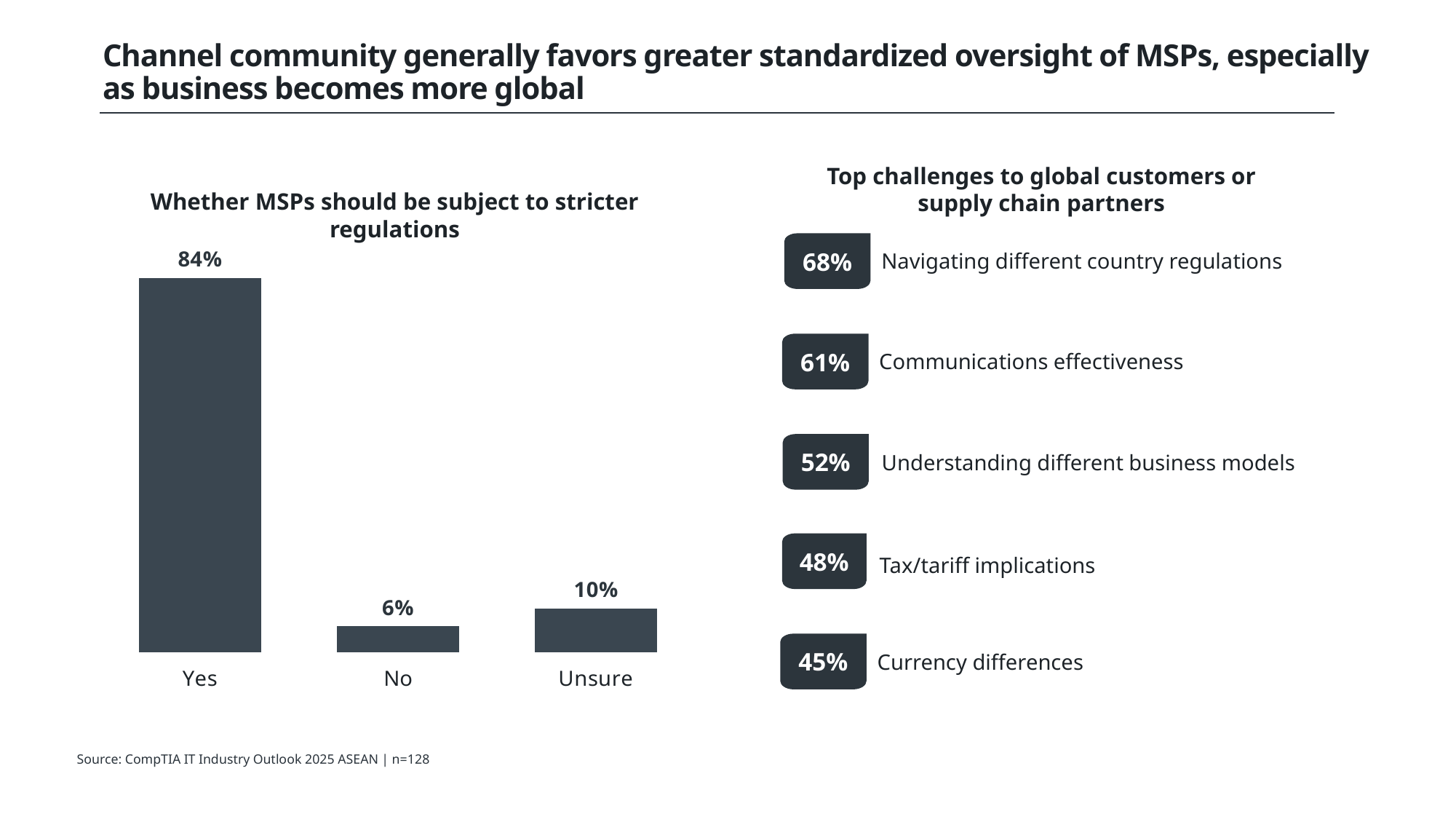
In the chart 'Whether MSPs should be subject to stricter regulations', what is the value for Unsure? 10% In the chart 'Whether MSPs should be subject to stricter regulations', what is the difference between the Yes and Unsure values? 74 percentage points In the chart 'Whether MSPs should be subject to stricter regulations', which is larger, No or Unsure? Unsure In the chart 'Whether MSPs should be subject to stricter regulations', what is the value for No? 6% In the 'Top challenges to global customers or supply chain partners' list, what is the value for Tax/tariff implications? 48% In the 'Top challenges to global customers or supply chain partners' list, which challenge has the highest value? Navigating different country regulations How many categories are shown in the chart 'Whether MSPs should be subject to stricter regulations'? 3 In the chart 'Whether MSPs should be subject to stricter regulations', which category has the lowest value? No In the chart 'Whether MSPs should be subject to stricter regulations', what is the value for Yes? 84% In the chart 'Whether MSPs should be subject to stricter regulations', which category has the highest value? Yes What kind of chart is 'Whether MSPs should be subject to stricter regulations'? Bar chart In the 'Top challenges to global customers or supply chain partners' list, what is the difference between Communications effectiveness and Currency differences? 16 percentage points